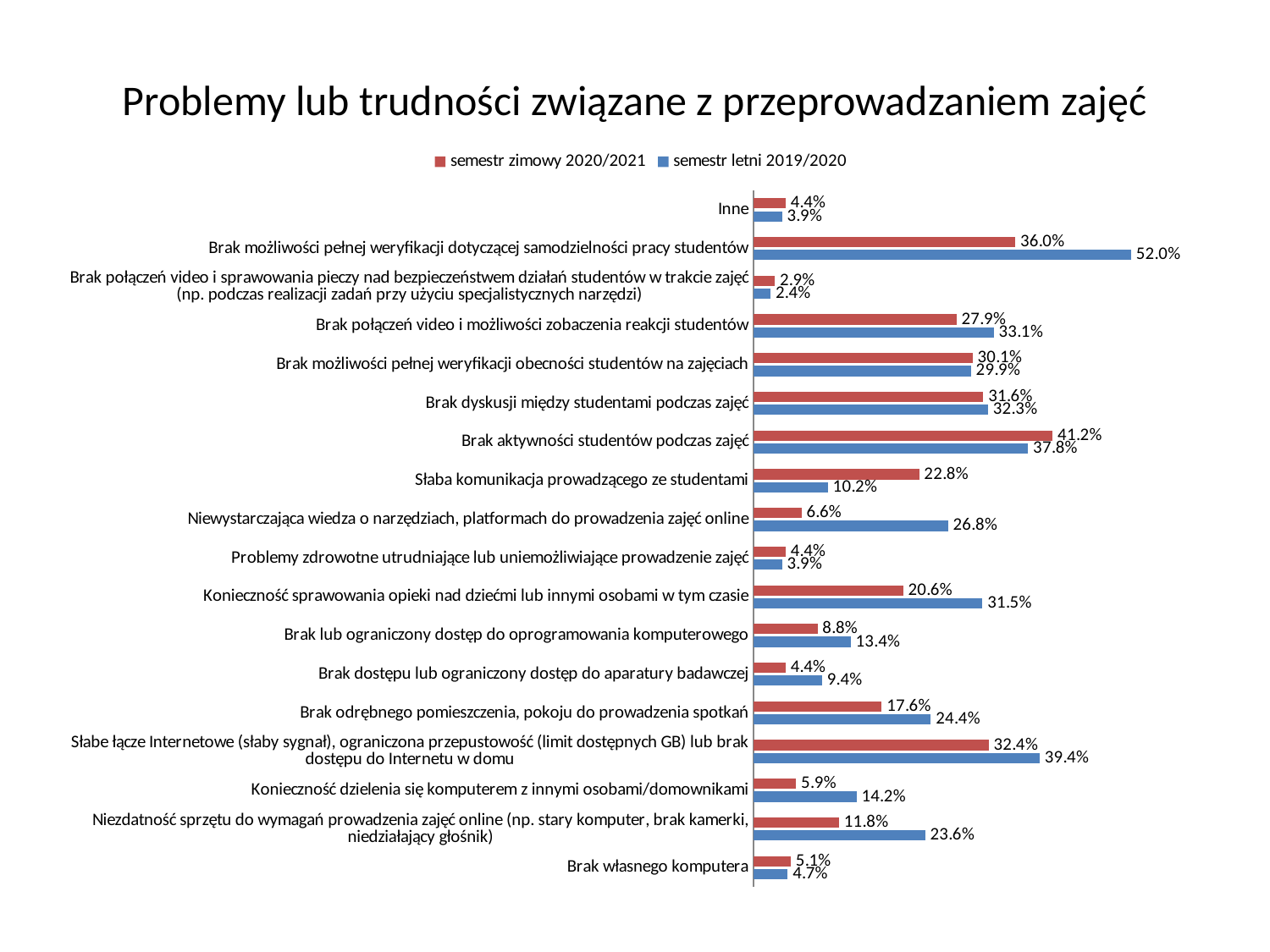
What is the difference between the two series for 'Konieczność dzielenia się komputerem z innymi osobami/domownikami'? 8.3% How many series does the legend list? 2 Which category has the lowest value in the 'semestr zimowy 2020/2021' series? Brak połączeń video i sprawowania pieczy nad bezpieczeństwem działań studentów w trakcie zajęć (np. podczas realizacji zadań przy użyciu specjalistycznych narzędzi) What is the difference between the 'semestr letni 2019/2020' and 'semestr zimowy 2020/2021' values for 'Brak możliwości pełnej weryfikacji dotyczącej samodzielności pracy studentów'? 16.0% What is the title of the chart? Problemy lub trudności związane z przeprowadzaniem zajęć What is the value for 'Brak aktywności studentów podczas zajęć' in the 'semestr zimowy 2020/2021' series? 41.2% What is the value for 'Brak własnego komputera' in the 'semestr letni 2019/2020' series? 4.7% Which category has the highest value in the 'semestr letni 2019/2020' series? Brak możliwości pełnej weryfikacji dotyczącej samodzielności pracy studentów For 'Niewystarczająca wiedza o narzędziach, platformach do prowadzenia zajęć online', which series has the larger value? semestr letni 2019/2020 What type of chart is shown on the slide? bar chart What is the value for 'Słaba komunikacja prowadzącego ze studentami' in the 'semestr letni 2019/2020' series? 10.2% How many categories are shown on the chart? 18